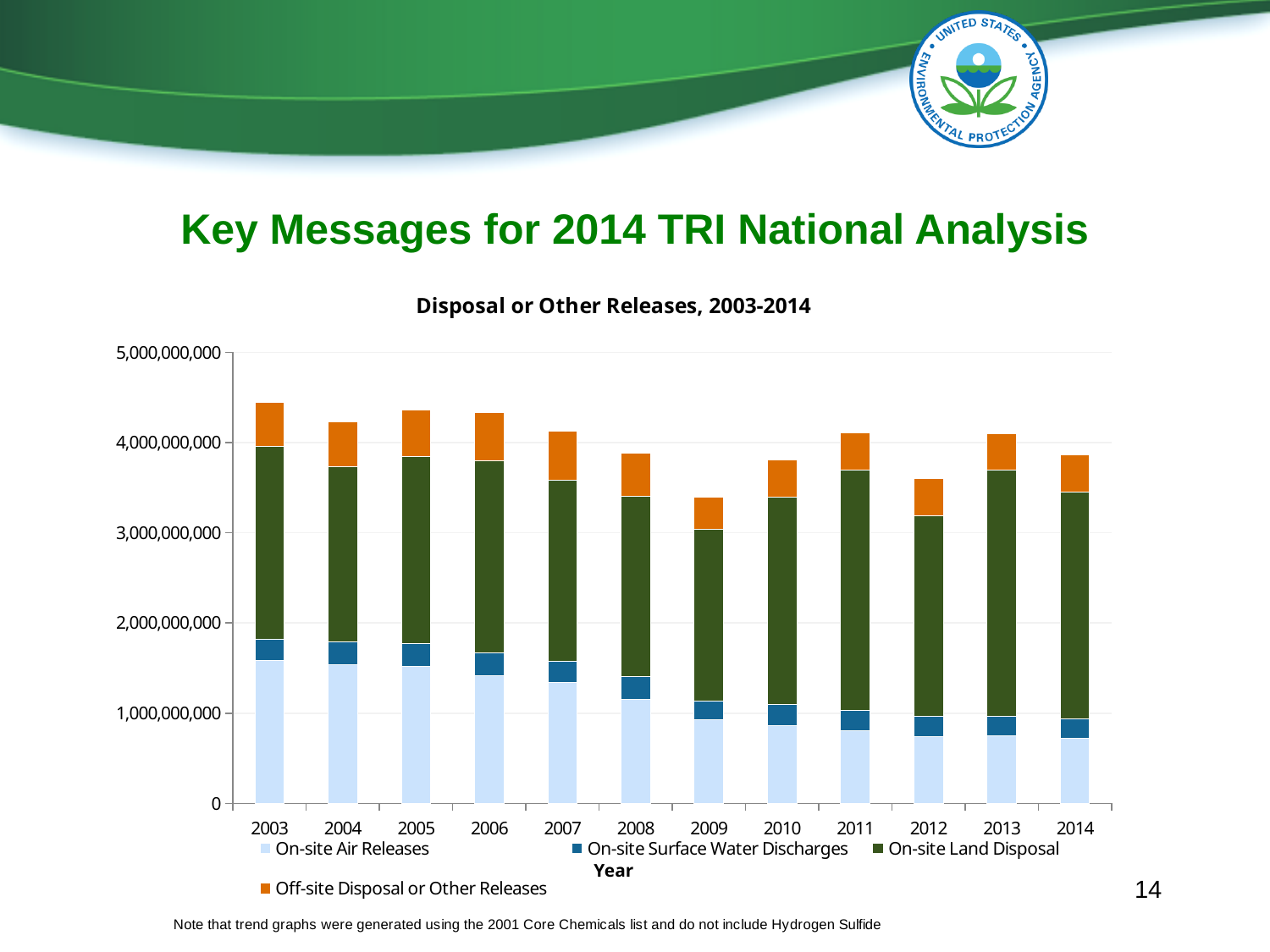
How many series does the chart's legend list? 4 What kind of chart is shown on the slide? Stacked bar chart Is the total bar for 2009 greater or less than 4,000,000,000? less How many years are shown along the x axis of the chart? 12 Is the total bar for 2003 greater or less than 4,000,000,000? greater What is the title of the chart? Disposal or Other Releases, 2003-2014 Which year has the lowest total bar in the chart? 2009 Which series is shown in dark green in the chart? On-site Land Disposal Is the On-site Air Releases value for 2014 greater or less than 1,000,000,000? less Which year has the highest total bar in the chart? 2003 Do the On-site Air Releases values generally rise or fall from 2003 to 2014? fall Which year has a larger total bar, 2003 or 2009? 2003